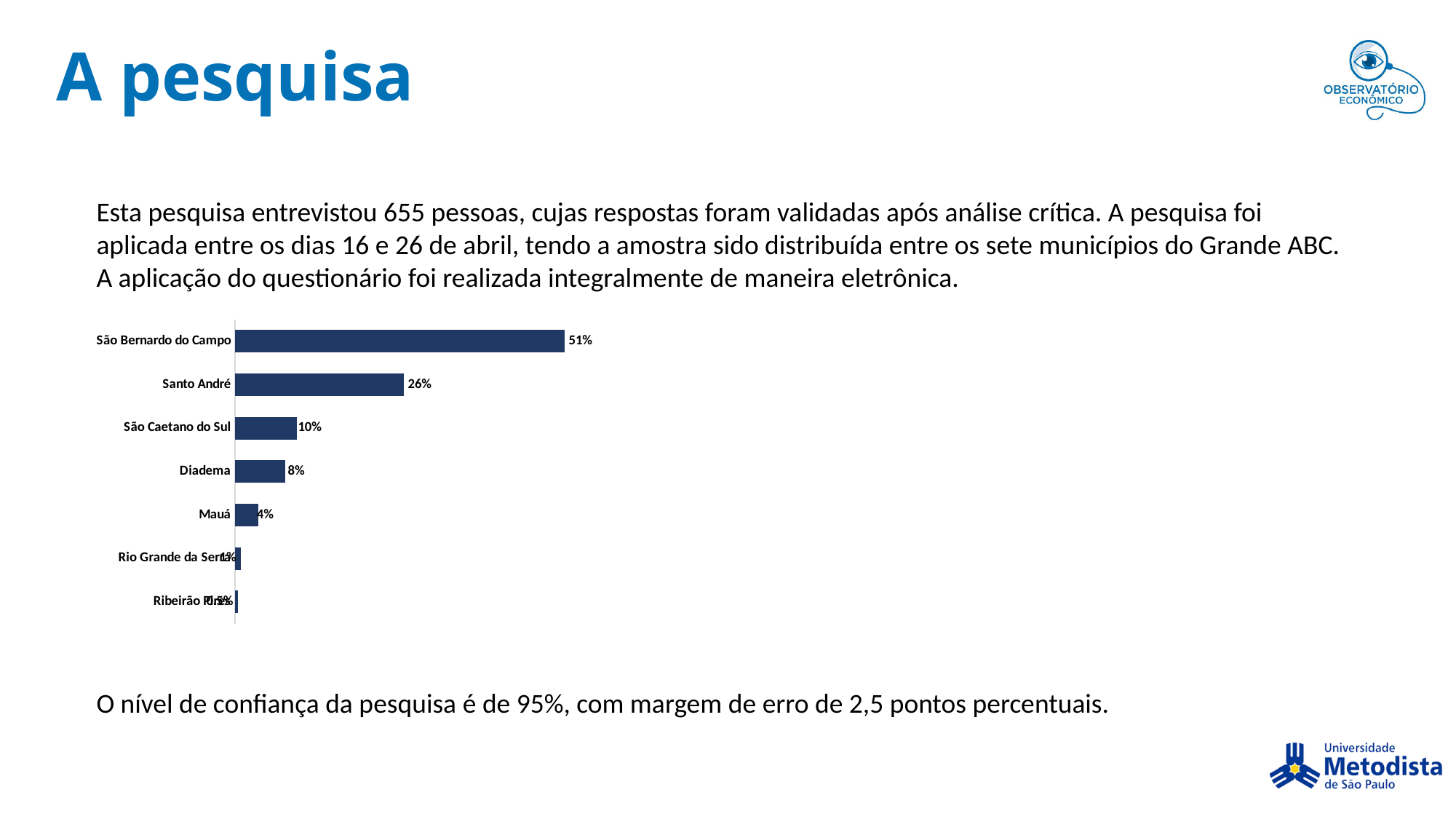
What is the value shown for Mauá? 4% Which has a larger share, Santo André or São Caetano do Sul? Santo André What percentage of the sample is from São Bernardo do Campo? 51% What is the difference in percentage points between São Caetano do Sul and Diadema? 2 percentage points Which municipality has the highest share of the sample? São Bernardo do Campo What is the value shown for Santo André? 26% What is the value shown for São Caetano do Sul? 10% What is the value shown for Diadema? 8% How many municipalities are shown in the chart? 7 Which has a larger share, Diadema or Mauá? Diadema What is the difference in percentage points between São Bernardo do Campo and Santo André? 25 percentage points What kind of chart is shown on the slide? Bar chart